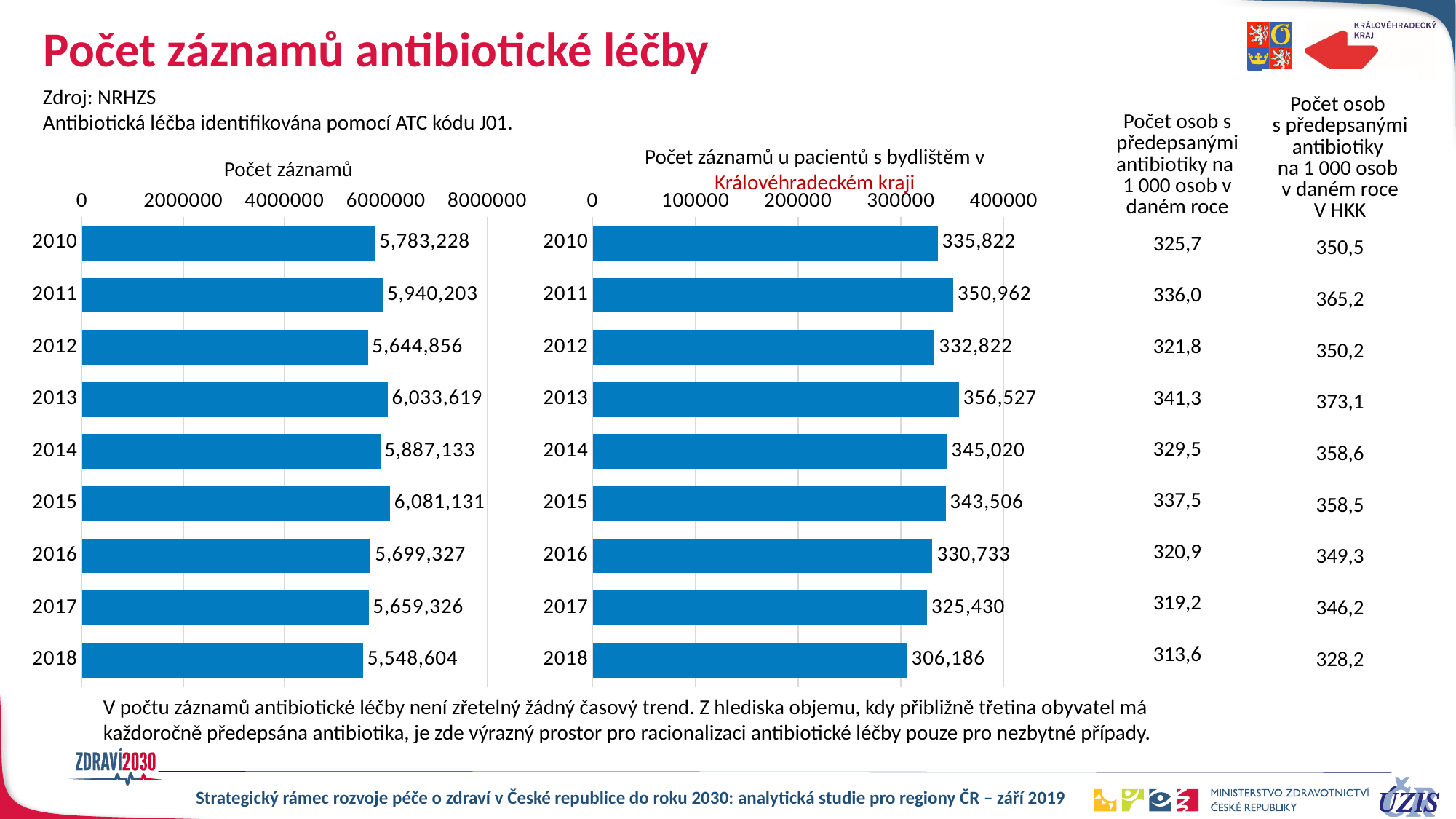
In the chart titled "Počet záznamů", which is larger, the value for 2011 or the value for 2014? 2011 In the chart titled "Počet záznamů", which year has the highest value? 2015 In the chart titled "Počet záznamů", what is the value for 2013? 6,033,619 In the chart titled "Počet záznamů u pacientů s bydlištěm v Královéhradeckém kraji", which year has the lowest value? 2018 In the chart titled "Počet záznamů u pacientů s bydlištěm v Královéhradeckém kraji", what is the value for 2016? 330,733 In the chart titled "Počet záznamů u pacientů s bydlištěm v Královéhradeckém kraji", is the value for 2018 greater or less than 300000? greater What kind of chart is the chart titled "Počet záznamů u pacientů s bydlištěm v Královéhradeckém kraji"? Bar chart In the chart titled "Počet záznamů", what is the difference between the values for 2015 and 2018? 532,527 In the chart titled "Počet záznamů u pacientů s bydlištěm v Královéhradeckém kraji", which year has the highest value? 2013 In the chart titled "Počet záznamů u pacientů s bydlištěm v Královéhradeckém kraji", what is the difference between the values for 2013 and 2018? 50,341 In the chart titled "Počet záznamů", which year has the lowest value? 2018 How many years are shown in the chart titled "Počet záznamů"? 9